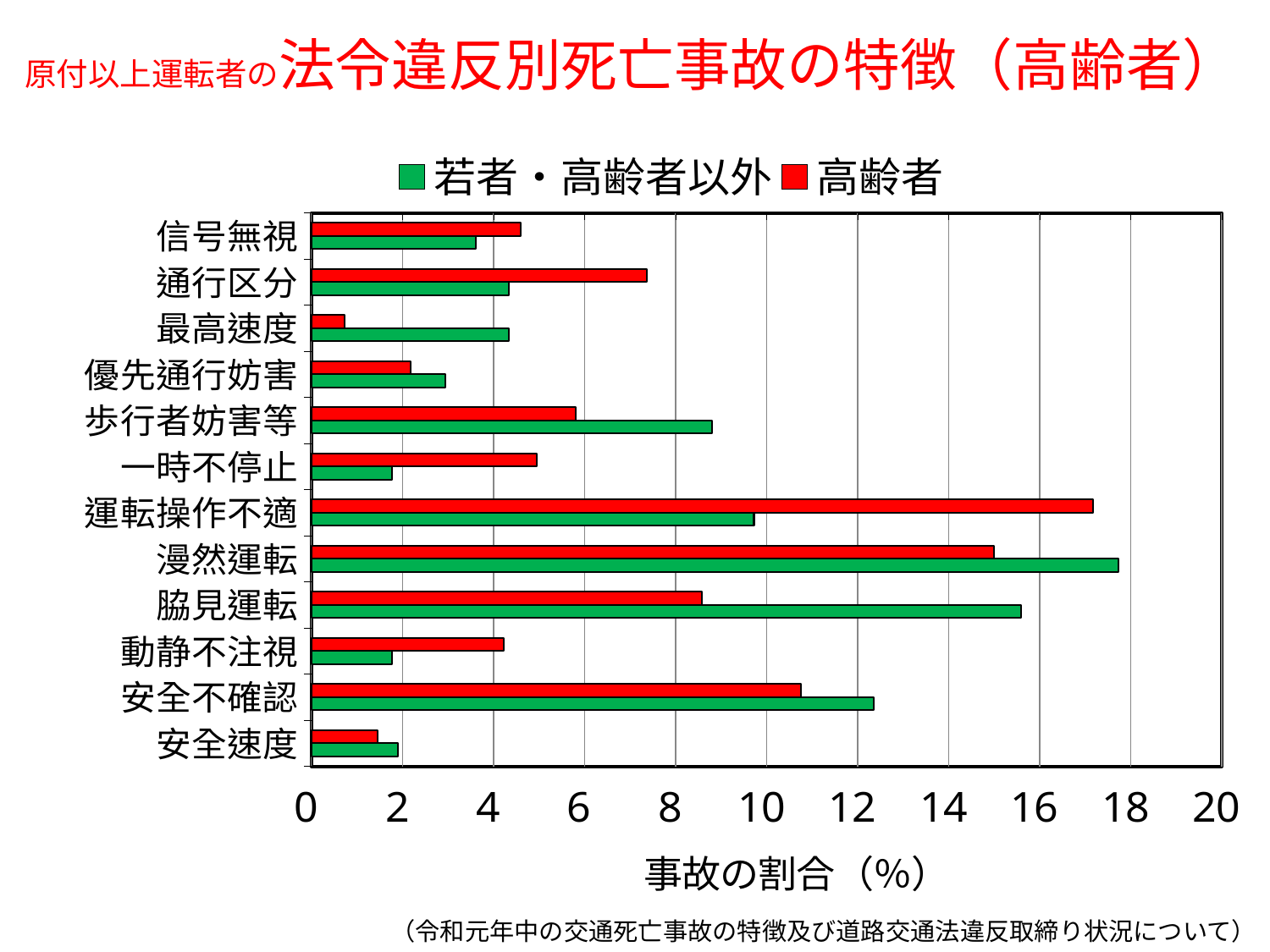
Is the 高齢者 value for 最高速度 greater or less than 2? less How many violation categories are plotted on the chart? 12 Is the 若者・高齢者以外 value for 脇見運転 greater or less than 14? greater Which category has the lowest value for 高齢者? 最高速度 How many series does the legend list? 2 Which category has the highest value for 高齢者? 運転操作不適 For 通行区分, which series has the larger value, 高齢者 or 若者・高齢者以外? 高齢者 Which category has the highest value for 若者・高齢者以外? 漫然運転 Is the 高齢者 value for 運転操作不適 greater or less than 16? greater What kind of chart is shown on the slide? bar chart What is the label of the x axis? 事故の割合（%） For 歩行者妨害等, which series has the larger value, 高齢者 or 若者・高齢者以外? 若者・高齢者以外